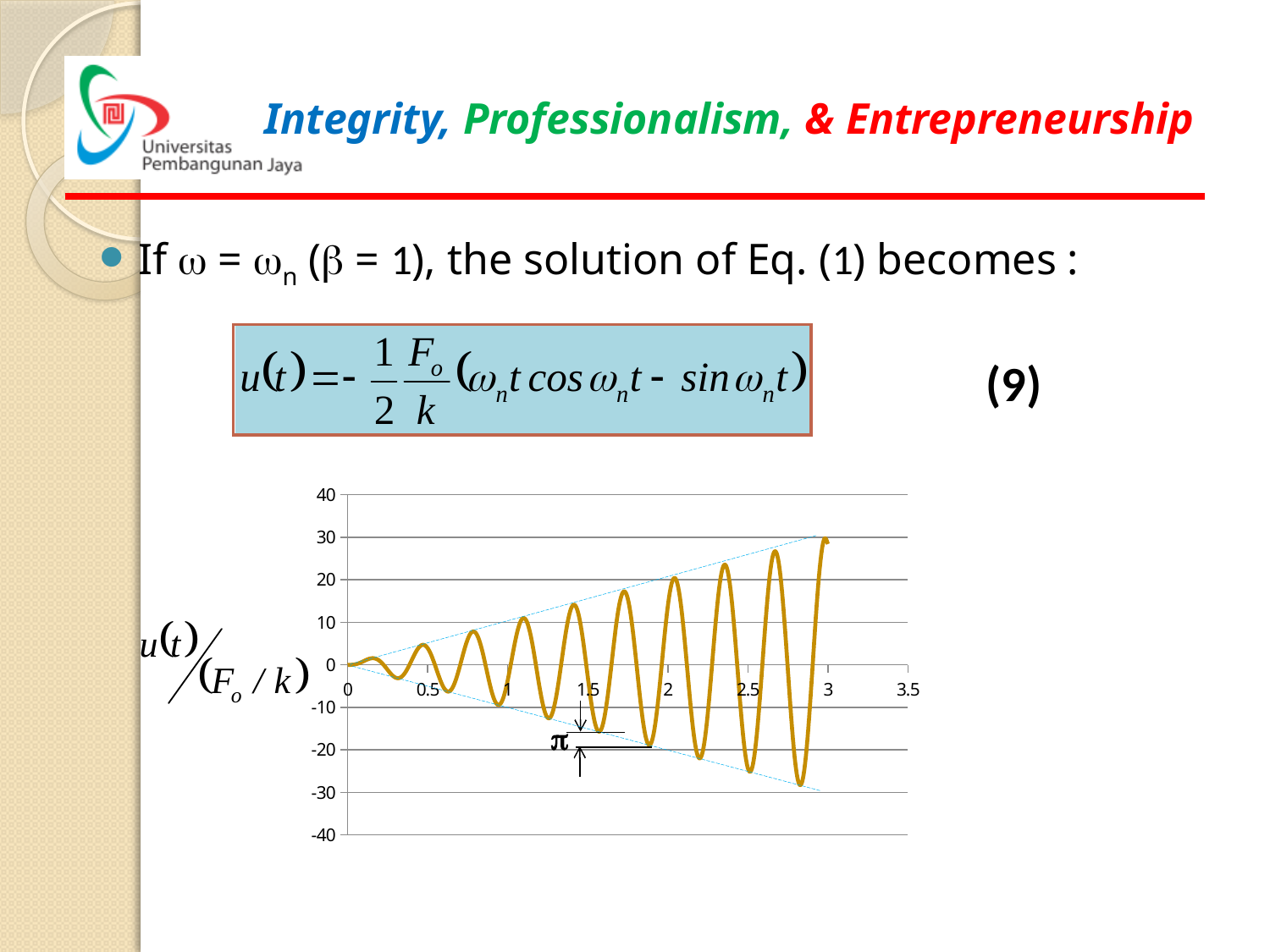
Is the highest peak of the curve, near x = 3, greater or less than 20? greater What is the largest tick value shown on the x-axis? 3.5 Does the amplitude of the oscillation increase or decrease as the x-axis value increases? increase What is the highest value shown on the y-axis? 40 Is the lowest trough of the curve, near x = 2.9, greater or less than -20? less What kind of chart is shown on the slide? line chart Is the value of the curve at x = 0 greater or less than 10? less